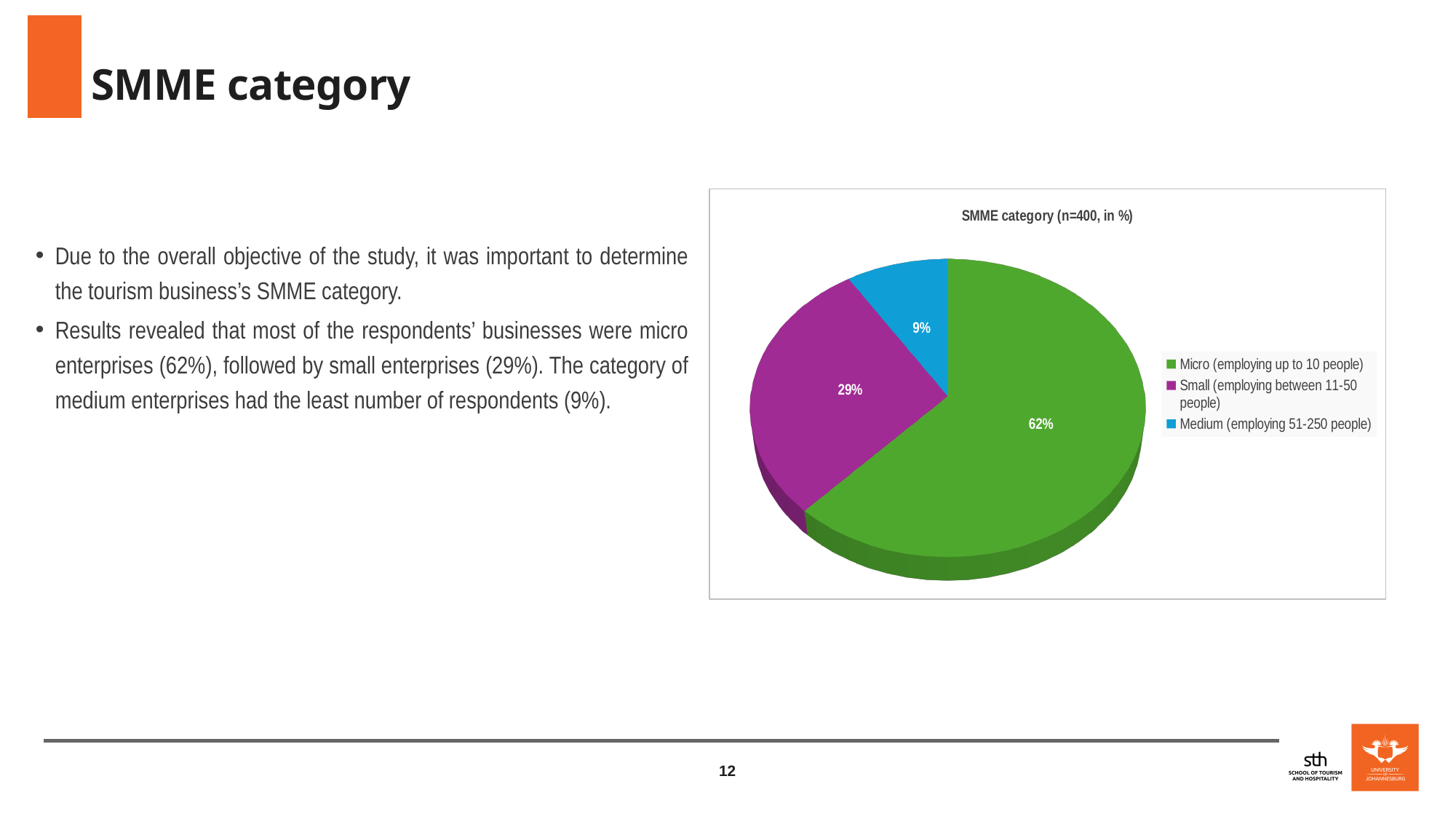
Which is larger, the share for Small enterprises or the share for Medium enterprises? Small enterprises What percentage of respondents' businesses are Medium (employing 51-250 people)? 9% How many categories does the pie chart show? 3 What is the title of the chart? SMME category (n=400, in %) What colour is the slice for Medium (employing 51-250 people)? Blue Which SMME category has the smallest share of the pie? Medium (employing 51-250 people) Which SMME category has the largest share of the pie? Micro (employing up to 10 people) What kind of chart is shown on the slide? Pie chart What percentage of respondents' businesses are Micro (employing up to 10 people)? 62% What is the difference in percentage points between the Micro and Small categories? 33 What is the difference in percentage points between the Small and Medium categories? 20 What percentage of respondents' businesses are Small (employing between 11-50 people)? 29%